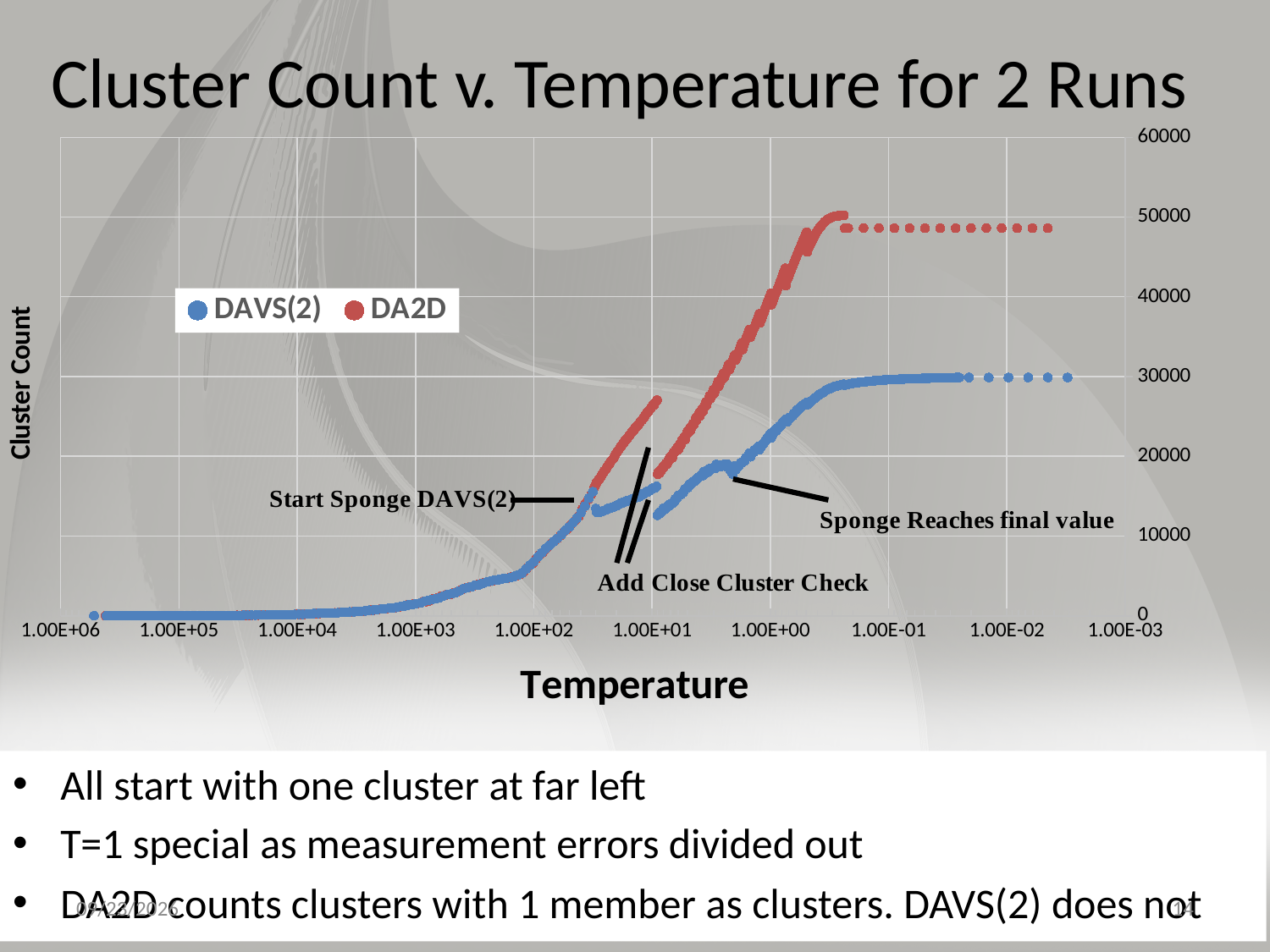
Which series reaches the higher cluster count at the right-hand end of the chart? DA2D Is the DAVS(2) cluster count at a temperature of 1.00E+03 greater or less than 10000? less What is the title of the vertical axis? Cluster Count What are the two series named in the legend? DAVS(2) and DA2D How many series does the legend list? 2 Is the DA2D cluster count at a temperature of 1.00E+00 greater or less than 30000? less Is the final (right-hand) cluster count for DAVS(2) greater or less than 20000? greater What kind of chart is shown on the slide? scatter chart Does the cluster count generally rise or fall moving from left to right along the temperature axis? rise Which series has the higher cluster count at a temperature of 1.00E+01? DA2D